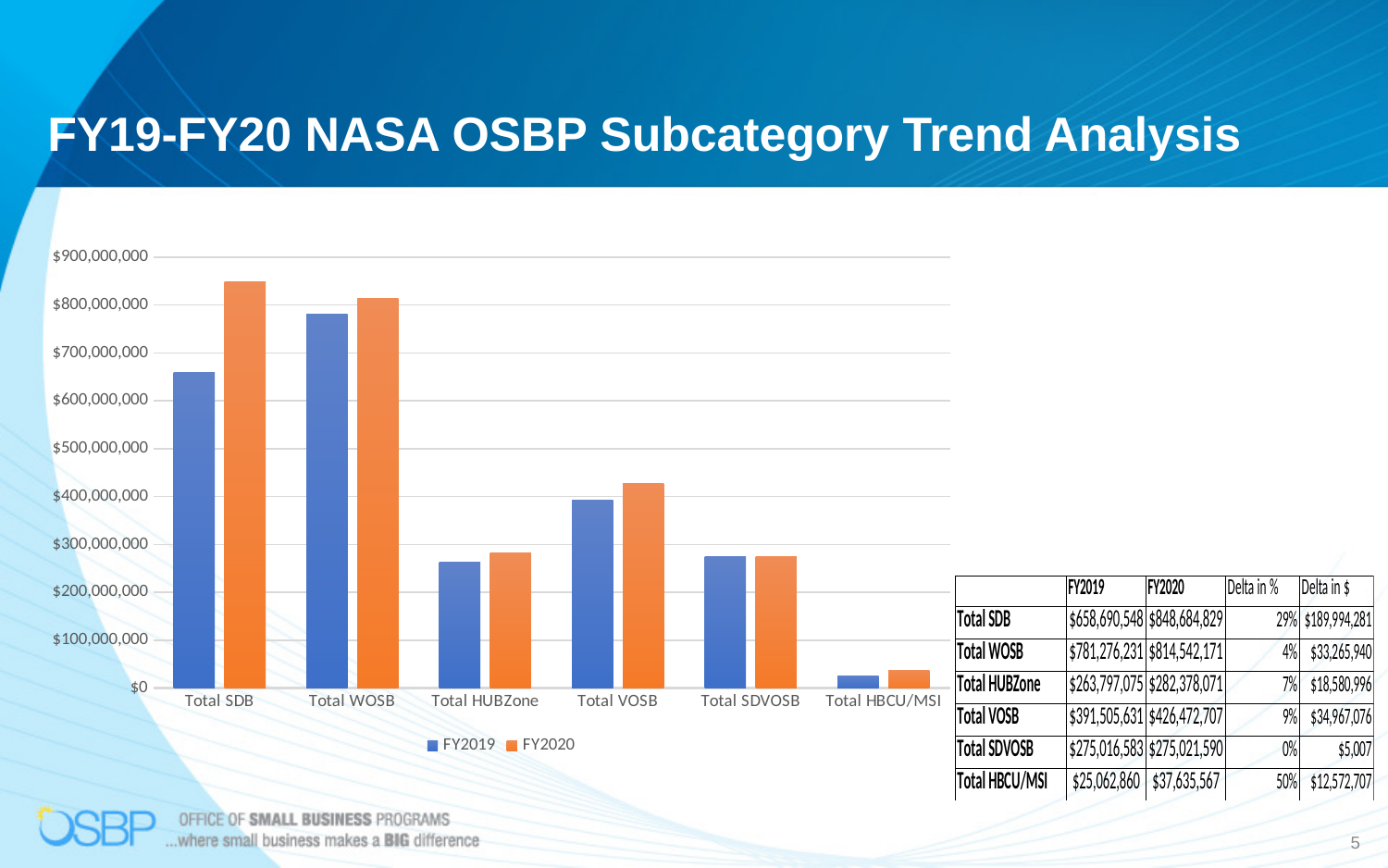
What is the difference in dollars between FY2020 and FY2019 for Total VOSB? $34,967,076 Which is larger, the FY2019 value for Total HUBZone or the FY2019 value for Total SDVOSB? Total SDVOSB Which category has the highest FY2020 value? Total SDB What is the Delta in % for Total HBCU/MSI? 50% Which colour represents FY2020 in the chart? orange What kind of chart is shown on the slide? bar chart Which category has the lowest FY2019 value? Total HBCU/MSI According to the table, what is the FY2020 value for Total SDB? $848,684,829 How many series does the chart legend list? 2 How many categories are shown on the x axis of the chart? 6 According to the table, what is the FY2019 value for Total WOSB? $781,276,231 Is the FY2020 bar for Total WOSB greater or less than $800,000,000? greater